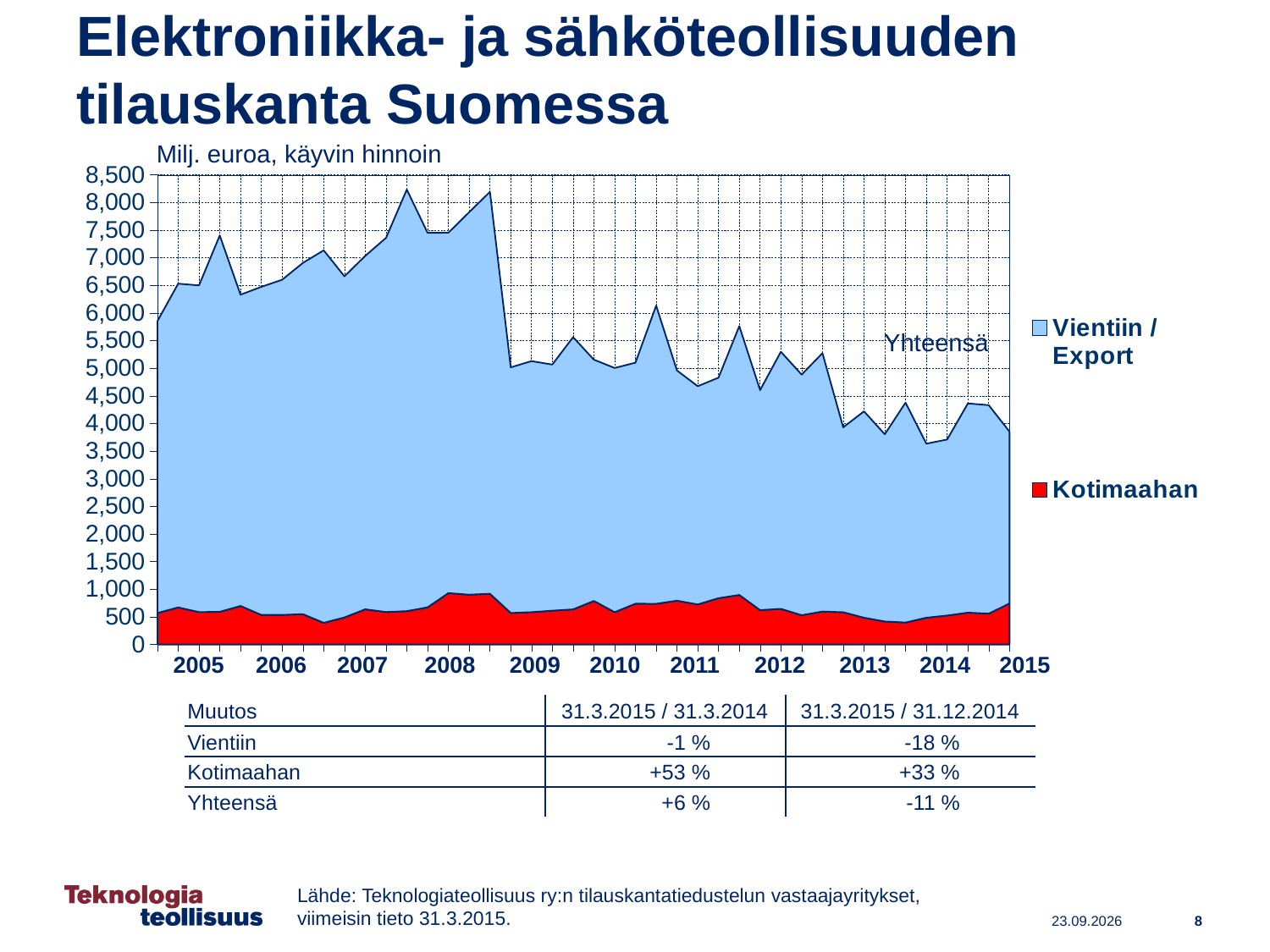
Is the total (Yhteensä) value at the 2014 tick greater or less than 4,000? less Is the highest total (Yhteensä) value reached around 2008 greater or less than 8,000? greater What kind of chart is shown on the slide? Stacked area chart Does the total (Yhteensä) order backlog rise or fall overall from 2008 to 2015? fall What unit is stated above the chart's y axis? Milj. euroa, käyvin hinnoin How many series does the chart legend list? 2 Is the total (Yhteensä) value at the start of 2009, after the sharp drop, greater or less than 5,500? less What are the two series named in the chart legend? Vientiin / Export and Kotimaahan How many years are labelled on the chart's x axis? 11 Which is larger, the total order backlog in 2008 or in 2015? 2008 In the table below the chart, what is the change for Kotimaahan for 31.3.2015 / 31.3.2014? +53 %